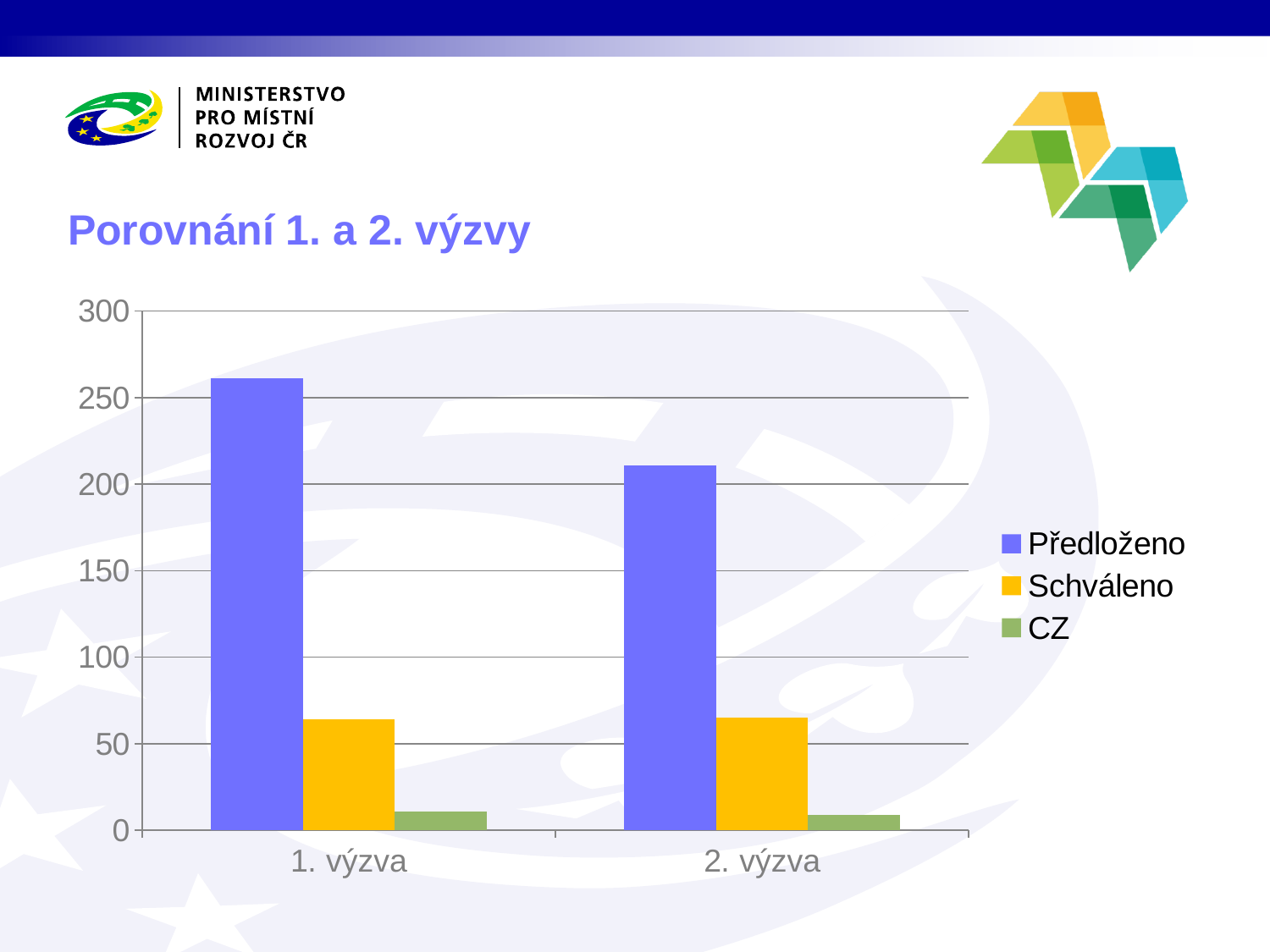
Is the value for Předloženo in 2. výzva greater or less than 200? greater Is the value for CZ in 2. výzva greater or less than 50? less Is the value for Schváleno in 1. výzva greater or less than 100? less Which series has the highest value in 1. výzva? Předloženo How many categories are shown on the x axis? 2 What is the title of the slide above the chart? Porovnání 1. a 2. výzvy Does the value for Předloženo rise or fall from 1. výzva to 2. výzva? fall What kind of chart is shown on the slide? bar chart Which is larger: Předloženo in 1. výzva or Předloženo in 2. výzva? 1. výzva How many series does the legend list? 3 Which series has the lowest value in 2. výzva? CZ